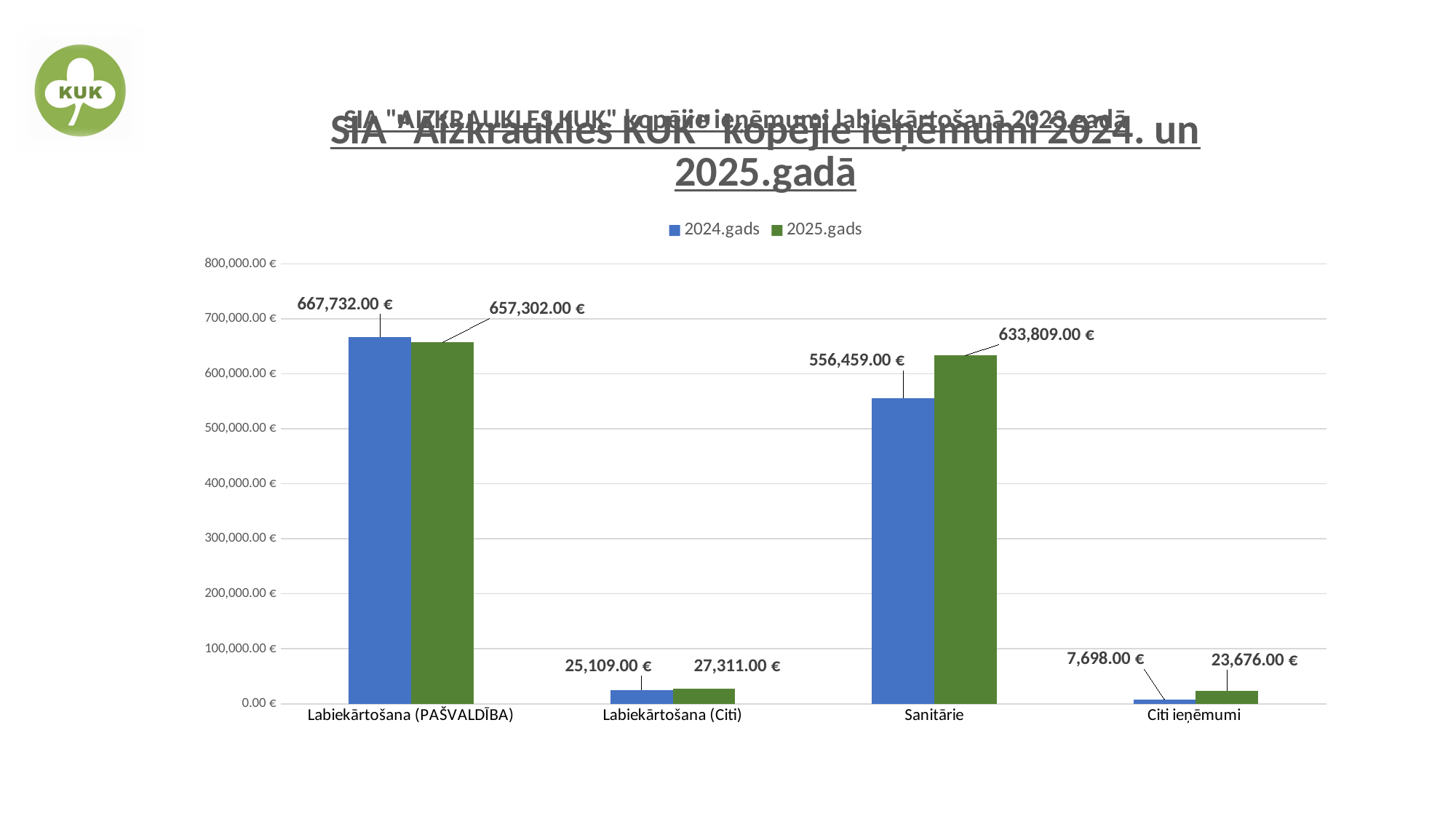
Which category has the highest 2025.gads value? Labiekārtošana (PAŠVALDĪBA) What kind of chart is shown on the slide? Bar chart How many categories are shown on the x axis? 4 Which category has the lowest 2024.gads value? Citi ieņēmumi What is the 2024.gads value for Citi ieņēmumi? 7,698.00 € For Citi ieņēmumi, which is larger: the 2024.gads value or the 2025.gads value? 2025.gads What is the 2025.gads value for Sanitārie? 633,809.00 € What is the 2025.gads value for Labiekārtošana (Citi)? 27,311.00 € What is the 2024.gads value for Labiekārtošana (PAŠVALDĪBA)? 667,732.00 € How many series does the legend list? 2 What is the difference between the 2025.gads and 2024.gads values for Sanitārie? 77,350.00 € What is the difference between the 2024.gads and 2025.gads values for Labiekārtošana (PAŠVALDĪBA)? 10,430.00 €